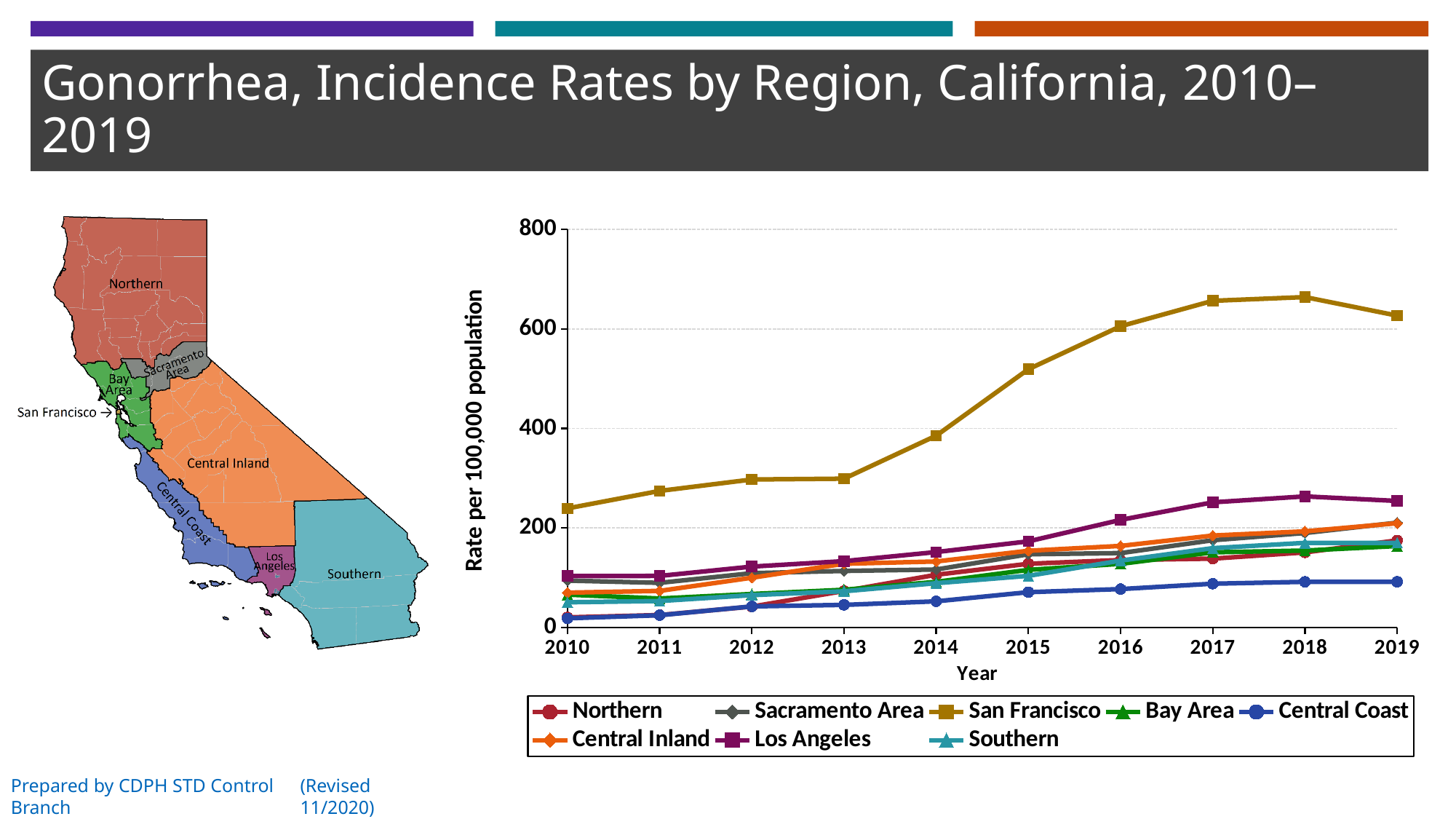
Is the value for San Francisco in 2018 greater or less than 600? greater Is the value for Central Coast in 2019 greater or less than 200? less Is the value for San Francisco in 2010 greater or less than 400? less In 2019, which is larger: the rate for Los Angeles or the rate for Central Inland? Los Angeles What is the label of the y axis of the chart? Rate per 100,000 population How many series does the chart legend list? 8 What kind of chart is shown on the slide? line chart How many years are plotted along the x axis of the chart? 10 Does the San Francisco rate rise or fall from 2010 to 2018? rise Which region has the highest gonorrhea incidence rate in 2019? San Francisco Which region has the lowest gonorrhea incidence rate in 2019? Central Coast